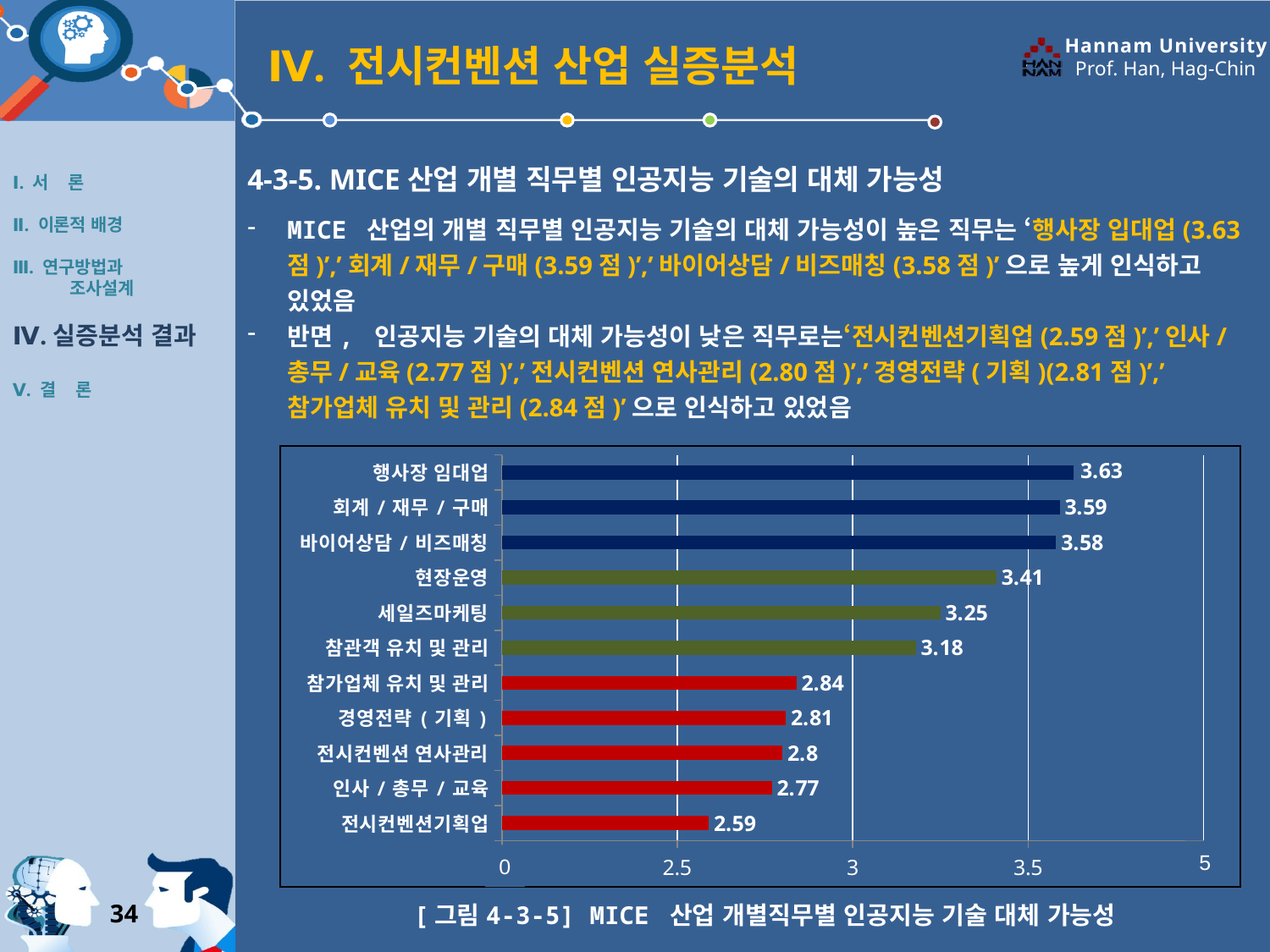
What is the value for 세일즈마케팅? 3.25 Which is larger, the value for 현장운영 or the value for 참가업체 유치 및 관리? 현장운영 What is the value for 전시컨벤션 연사관리? 2.8 Is the value for 인사 / 총무 / 교육 greater or less than 3? less What is the difference between the values for 행사장 임대업 and 전시컨벤션기획업? 1.04 Which category has the lowest value? 전시컨벤션기획업 What is the caption of the chart shown below the bars? [그림 4-3-5] MICE 산업 개별직무별 인공지능 기술 대체 가능성 What kind of chart is shown on the slide? bar chart Which category has the highest value? 행사장 임대업 How many categories are shown in the chart? 11 What is the difference between the values for 현장운영 and 참관객 유치 및 관리? 0.23 What is the value for 행사장 임대업? 3.63